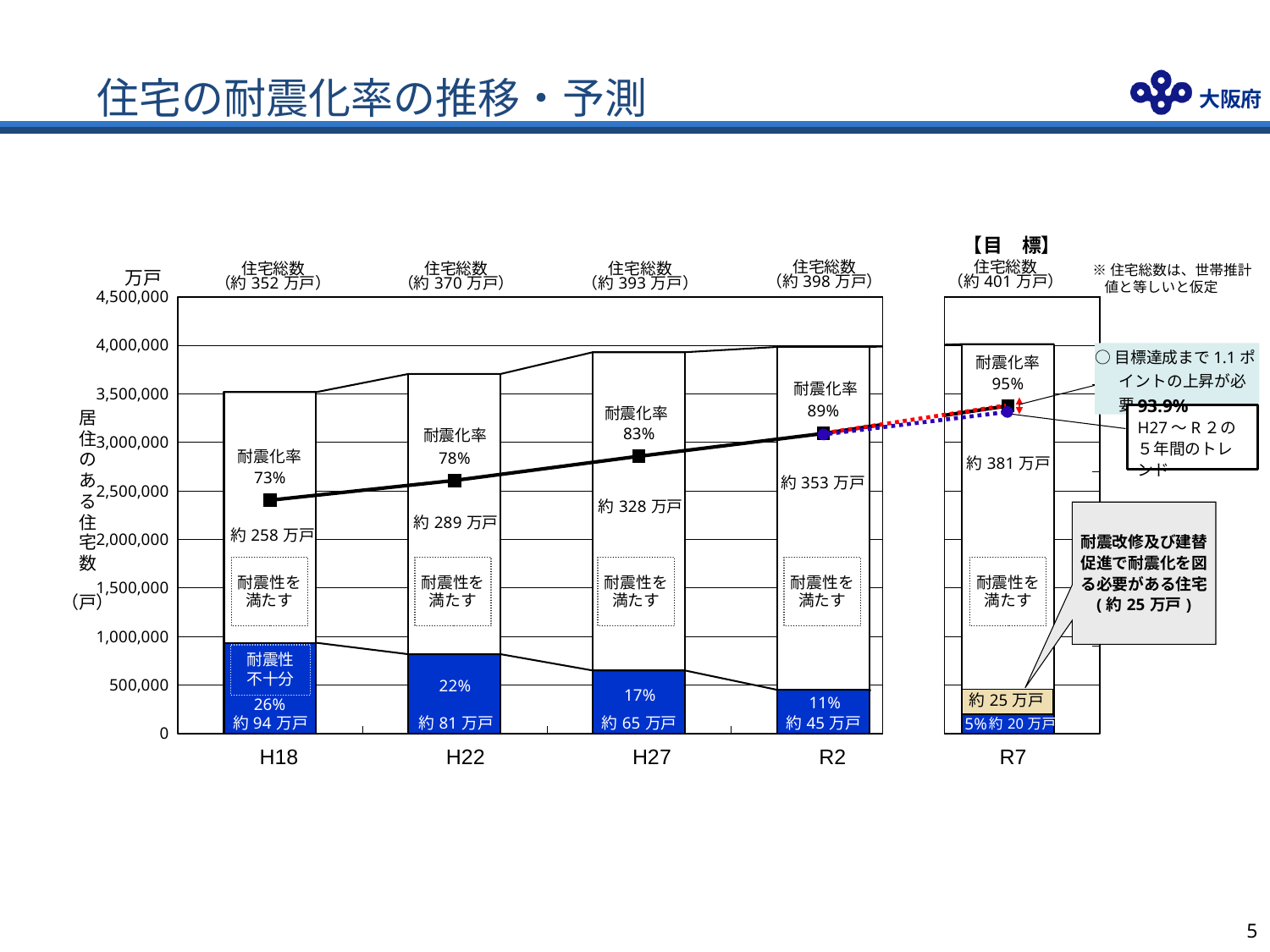
耐震化率はH18からR7にかけて上昇していますか、下降していますか？ 上昇 横軸に示されている年度はいくつありますか？ 5 H22とH27では、耐震性不十分の割合が大きいのはどちらですか？ H22 H18の耐震化率は何%ですか？ 73% 耐震性不十分の割合が最も高い年度はどれですか？ H18 H18からR2までに耐震化率は何ポイント上昇しましたか？ 16ポイント H27の耐震性不十分の住宅の割合は何%ですか？ 17% R2の耐震化率は何%ですか？ 89% このグラフはどのような種類のグラフですか？ 棒グラフと折れ線グラフの組み合わせ R7の目標耐震化率は何%ですか？ 95% R2の耐震性を満たす住宅数はいくつと表示されていますか？ 約 353 万戸 耐震化率が最も低い年度はどれですか？ H18